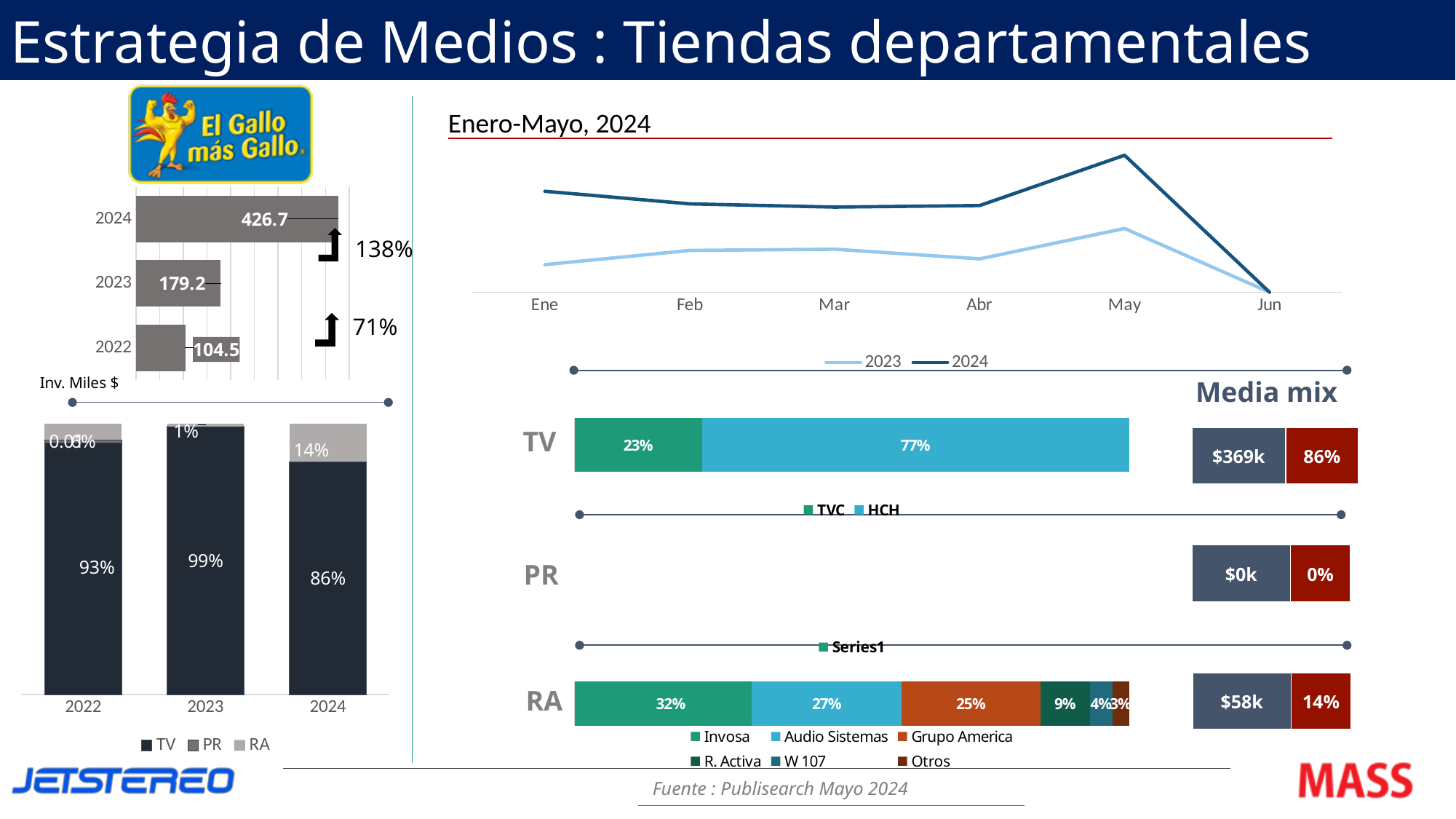
In the Media mix boxes on the right, what is the amount shown for RA? $58k In the horizontal bar chart of investment by year on the left, what is the difference between the 2024 and 2023 values? 247.5 In the RA stacked bar on the right, which station has the largest share? Invosa In the stacked bar chart of TV/PR/RA by year at the bottom left, what is the TV share for 2023? 99% In the line chart titled Enero-Mayo, 2024, how many months are shown on the x axis? 6 In the horizontal bar chart of investment by year on the left, what is the value for 2022? 104.5 In the TV stacked bar on the right, what is the share for HCH? 77% How many series does the legend of the stacked bar chart at the bottom left list? 3 In the horizontal bar chart of investment by year (Inv. Miles $) on the left, what is the value for 2024? 426.7 In the stacked bar chart of TV/PR/RA by year at the bottom left, what is the RA share for 2024? 14% What kind of chart is the Enero-Mayo, 2024 chart at the top right? Line chart In the horizontal bar chart of investment by year on the left, which year has the highest value? 2024